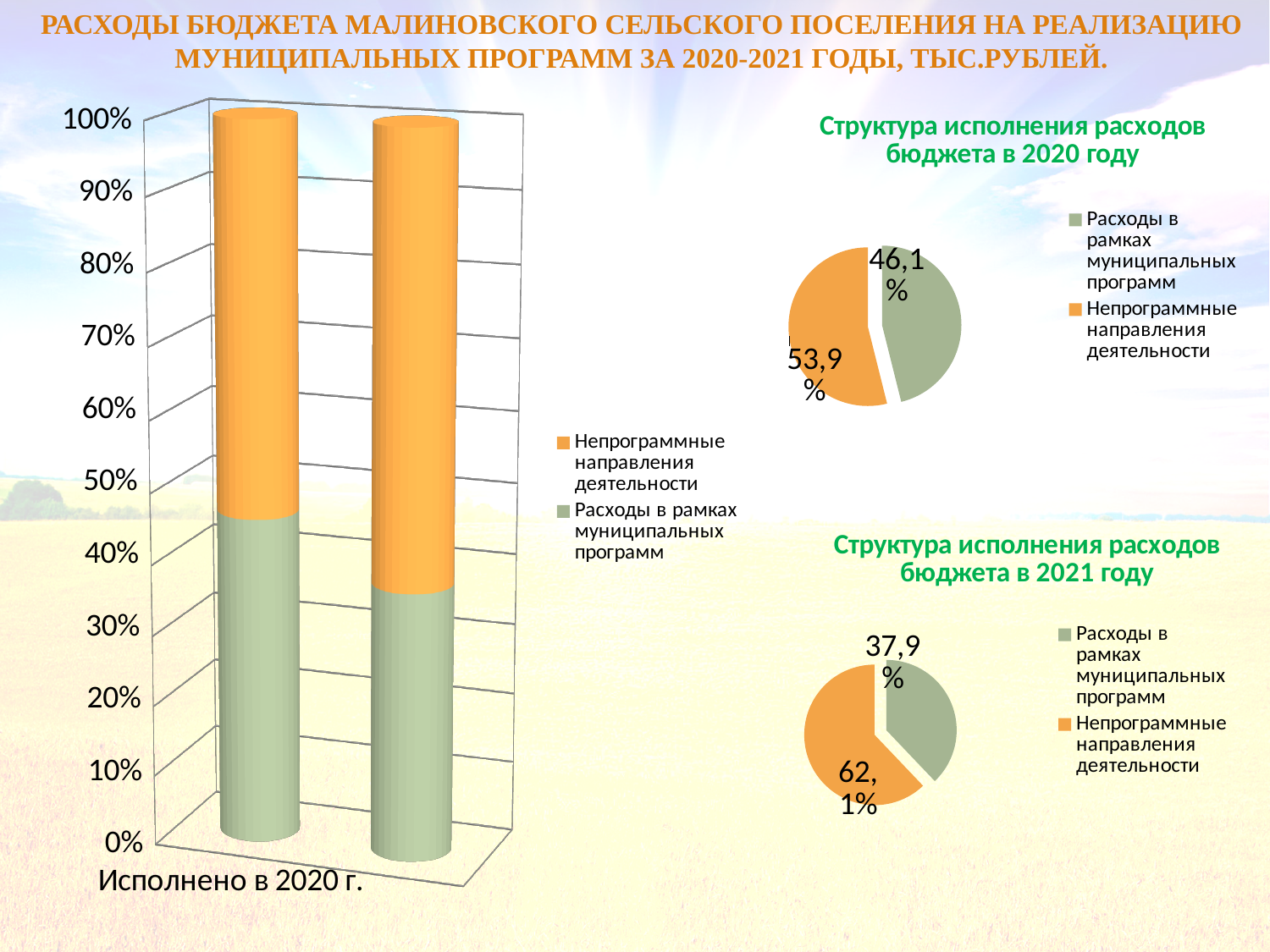
In the pie chart titled 'Структура исполнения расходов бюджета в 2020 году', what is the share for 'Расходы в рамках муниципальных программ'? 46,1% In the bar chart on the left, is the green 'Расходы в рамках муниципальных программ' segment of the first bar greater or less than 50%? less How many series does the legend of the bar chart on the left list? 2 Comparing the two pie charts, is the share of 'Расходы в рамках муниципальных программ' larger in 2020 or in 2021? 2020 In the pie chart titled 'Структура исполнения расходов бюджета в 2020 году', by how many percentage points does 'Непрограммные направления деятельности' exceed 'Расходы в рамках муниципальных программ'? 7,8 In the pie chart titled 'Структура исполнения расходов бюджета в 2021 году', by how many percentage points does 'Непрограммные направления деятельности' exceed 'Расходы в рамках муниципальных программ'? 24,2 In the pie chart titled 'Структура исполнения расходов бюджета в 2021 году', what is the share for 'Расходы в рамках муниципальных программ'? 37,9% In the pie chart titled 'Структура исполнения расходов бюджета в 2021 году', which slice is the largest? Непрограммные направления деятельности In the pie chart titled 'Структура исполнения расходов бюджета в 2021 году', what is the share for 'Непрограммные направления деятельности'? 62,1% In the pie chart titled 'Структура исполнения расходов бюджета в 2020 году', which slice is the smallest? Расходы в рамках муниципальных программ In the pie chart titled 'Структура исполнения расходов бюджета в 2020 году', what is the share for 'Непрограммные направления деятельности'? 53,9% What kind of chart is the chart on the left side of the slide? Stacked bar chart